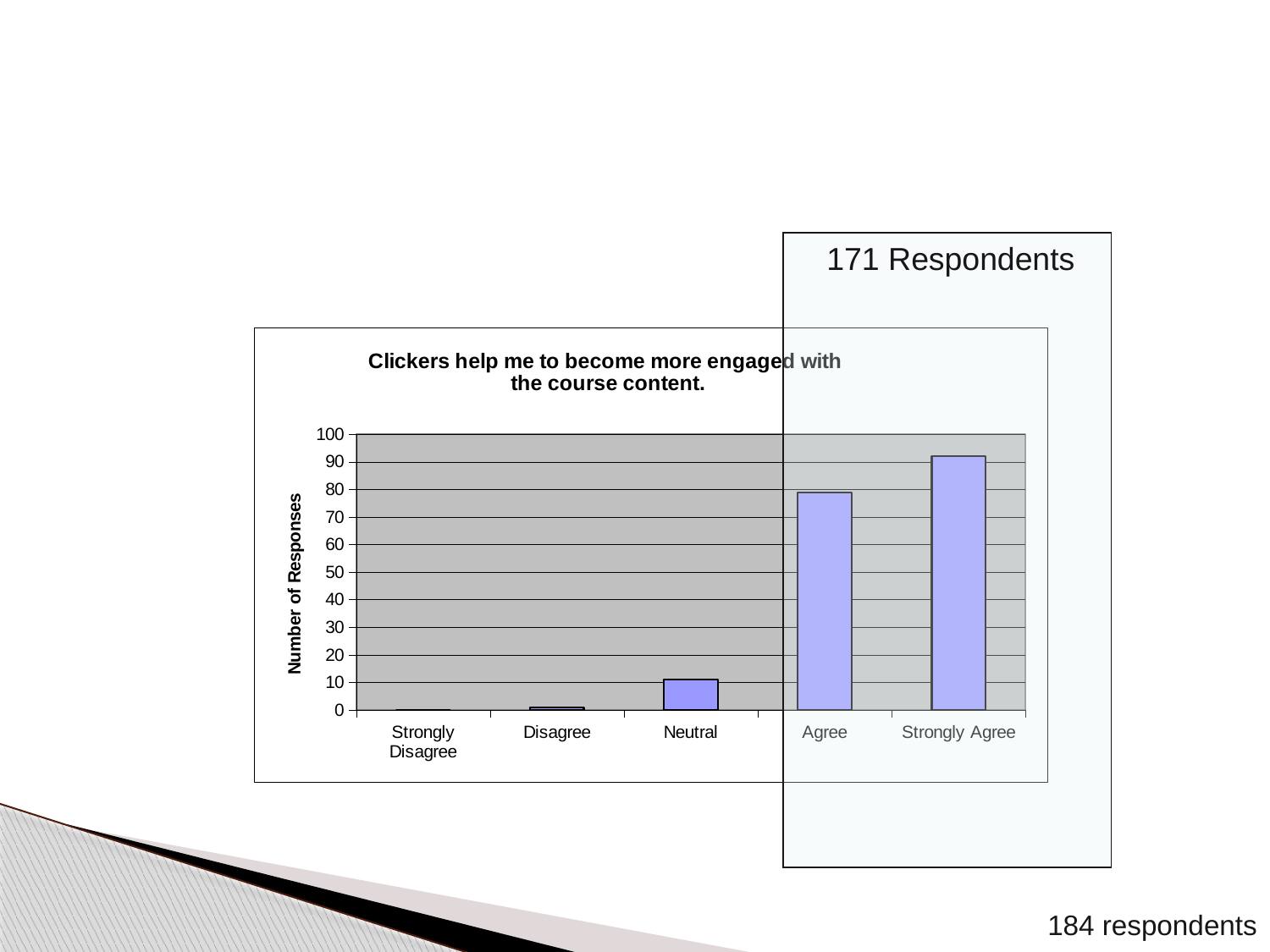
How many categories are shown on the x axis of the chart? 5 Is the value for Neutral greater or less than 20? less What is the label of the y axis? Number of Responses Which category has the highest number of responses? Strongly Agree Which has more responses, Agree or Neutral? Agree What kind of chart is shown on the slide? bar chart What is the title of the chart? Clickers help me to become more engaged with the course content. Which has more responses, Strongly Agree or Agree? Strongly Agree Which category has the lowest number of responses? Strongly Disagree Is the value for Agree greater or less than 70? greater Is the value for Disagree greater or less than 10? less